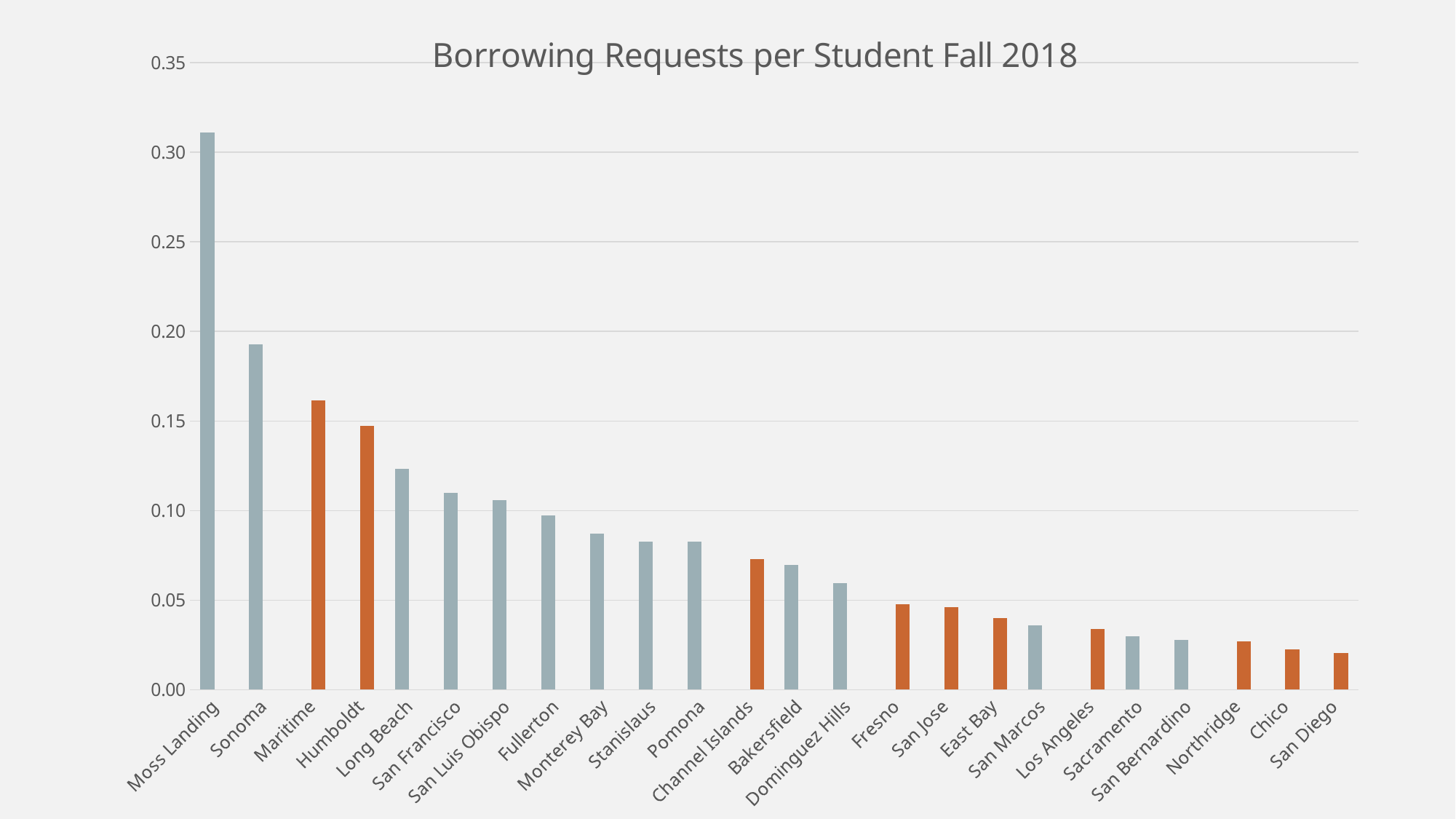
Do the values generally rise or fall moving from left to right along the x axis? fall What kind of chart is shown on the slide? bar chart Which campus has the highest borrowing requests per student? Moss Landing Is the value for Moss Landing greater or less than 0.30? greater Is the value for Maritime greater or less than 0.15? greater Which has a higher value, Long Beach or San Francisco? Long Beach How many campuses are shown on the x axis of the chart? 24 Which has a higher value, Maritime or Humboldt? Maritime Is the value for San Diego greater or less than 0.05? less What is the title of the chart? Borrowing Requests per Student Fall 2018